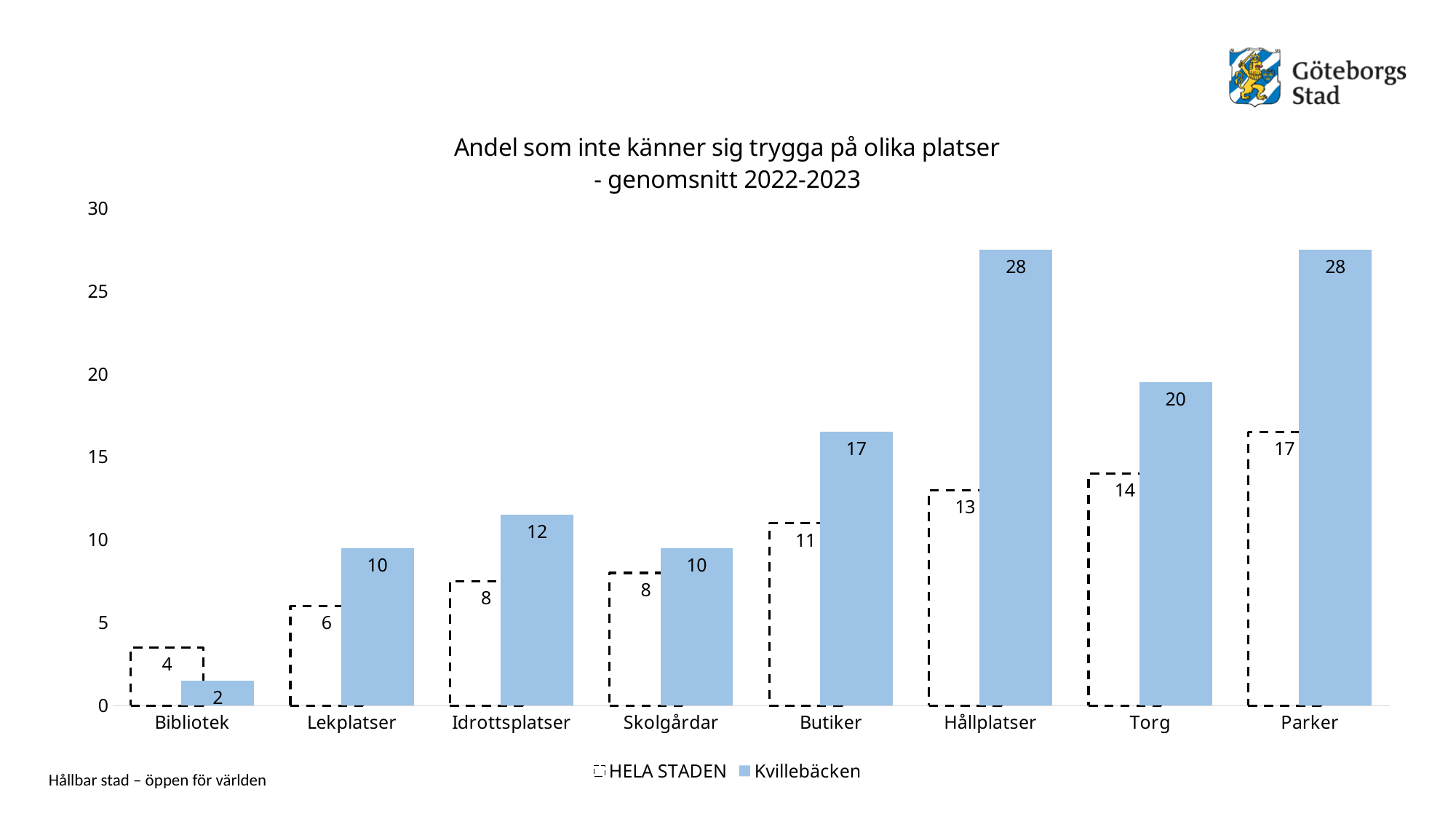
Which category has the lowest value for Kvillebäcken? Bibliotek Which category has the highest value for HELA STADEN? Parker What is the title of the chart? Andel som inte känner sig trygga på olika platser - genomsnitt 2022-2023 What is the value for Kvillebäcken at Hållplatser? 28 How many series does the legend list? 2 What is the difference between Kvillebäcken and HELA STADEN at Hållplatser? 15 What kind of chart is shown on the slide? bar chart What is the value for Kvillebäcken at Bibliotek? 2 How many categories are shown on the x axis? 8 Is the value for Kvillebäcken at Torg greater or less than 15? greater What is the value for HELA STADEN at Butiker? 11 Which is larger at Bibliotek, HELA STADEN or Kvillebäcken? HELA STADEN